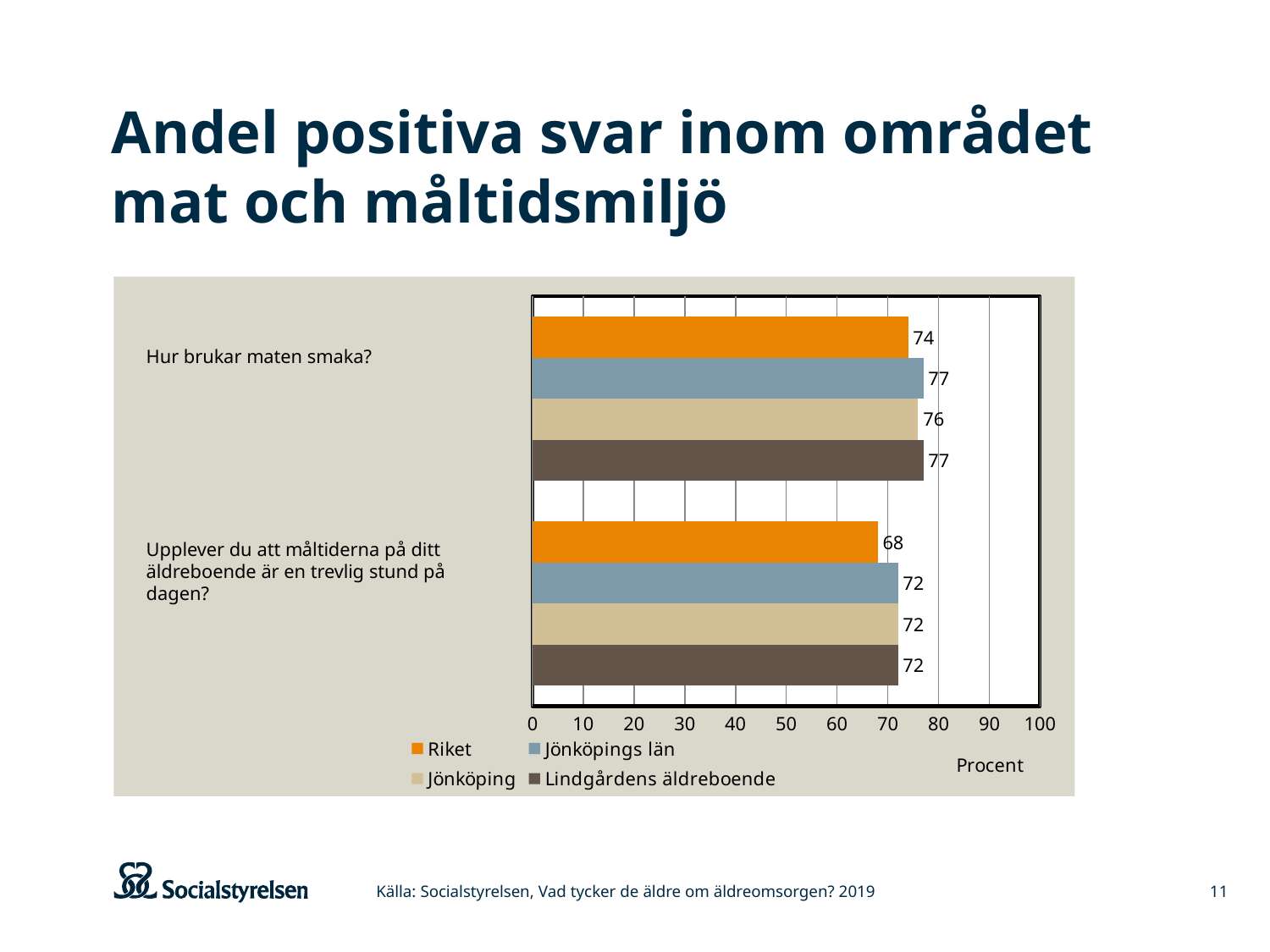
What kind of chart is shown on the slide? Bar chart How many series does the legend list? 4 What is the value for Riket for the question "Upplever du att måltiderna på ditt äldreboende är en trevlig stund på dagen?"? 68 For the question "Hur brukar maten smaka?", which is larger: the value for Jönköping or the value for Riket? Jönköping What is the difference between the Jönköpings län value and the Riket value for the question "Hur brukar maten smaka?"? 3 What is the value for Jönköping for the question "Upplever du att måltiderna på ditt äldreboende är en trevlig stund på dagen?"? 72 What is the difference between the Lindgårdens äldreboende value and the Riket value for the question "Upplever du att måltiderna på ditt äldreboende är en trevlig stund på dagen?"? 4 What is the value for Riket for the question "Hur brukar maten smaka?"? 74 How many question categories are shown on the chart? 2 What is the value for Jönköpings län for the question "Hur brukar maten smaka?"? 77 Is the value for Riket for the question "Upplever du att måltiderna på ditt äldreboende är en trevlig stund på dagen?" greater or less than 70? less Which series has the lowest value for the question "Upplever du att måltiderna på ditt äldreboende är en trevlig stund på dagen?"? Riket